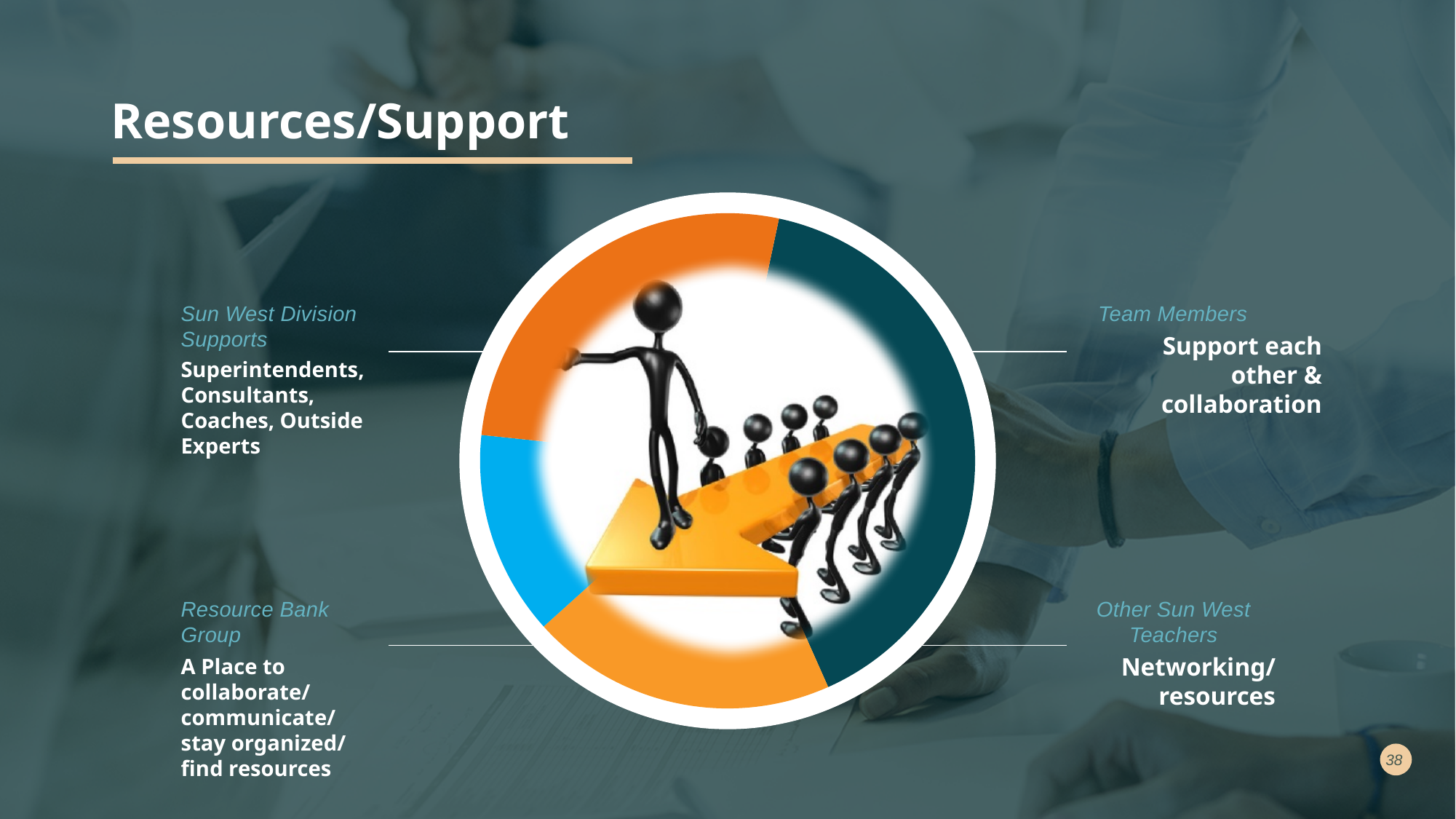
How many segments does the ring chart have? 4 What kind of chart is shown in the centre of the slide? A donut (ring) chart How many text callouts are connected to the ring chart? 4 Which callout label is connected to the upper-left of the ring chart? Sun West Division Supports What is the title of the slide containing the ring chart? Resources/Support Which colour segment of the ring chart is the smallest? Light blue Is the light blue segment of the ring chart larger or smaller than the dark teal segment? Smaller